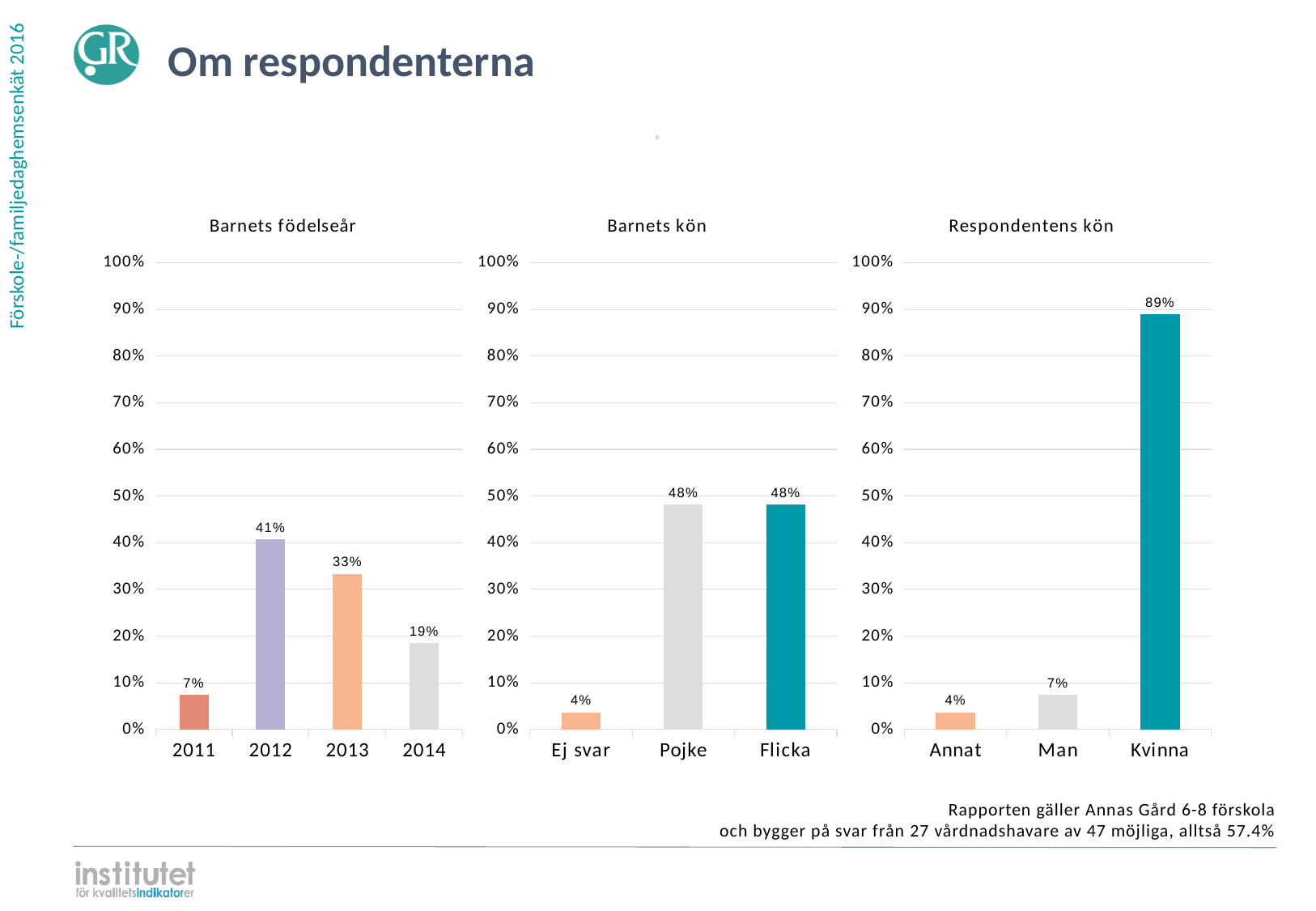
What type of chart is the 'Barnets kön' chart? Bar chart In the 'Barnets födelseår' chart, what is the value for 2012? 41% In the 'Barnets födelseår' chart, what is the difference between the values for 2013 and 2014? 14% In the 'Barnets födelseår' chart, which birth year has the lowest value? 2011 In the 'Barnets kön' chart, what is the value for Ej svar? 4% In the 'Barnets kön' chart, is the value for Flicka greater or less than 40%? greater In the 'Barnets födelseår' chart, how many birth-year categories are shown? 4 In the 'Respondentens kön' chart, what is the difference between the values for Kvinna and Man? 82% In the 'Barnets kön' chart, what is the value for Pojke? 48% In the 'Respondentens kön' chart, which category has the highest value? Kvinna In the 'Respondentens kön' chart, which is larger, the value for Man or the value for Annat? Man In the 'Respondentens kön' chart, what is the value for Kvinna? 89%